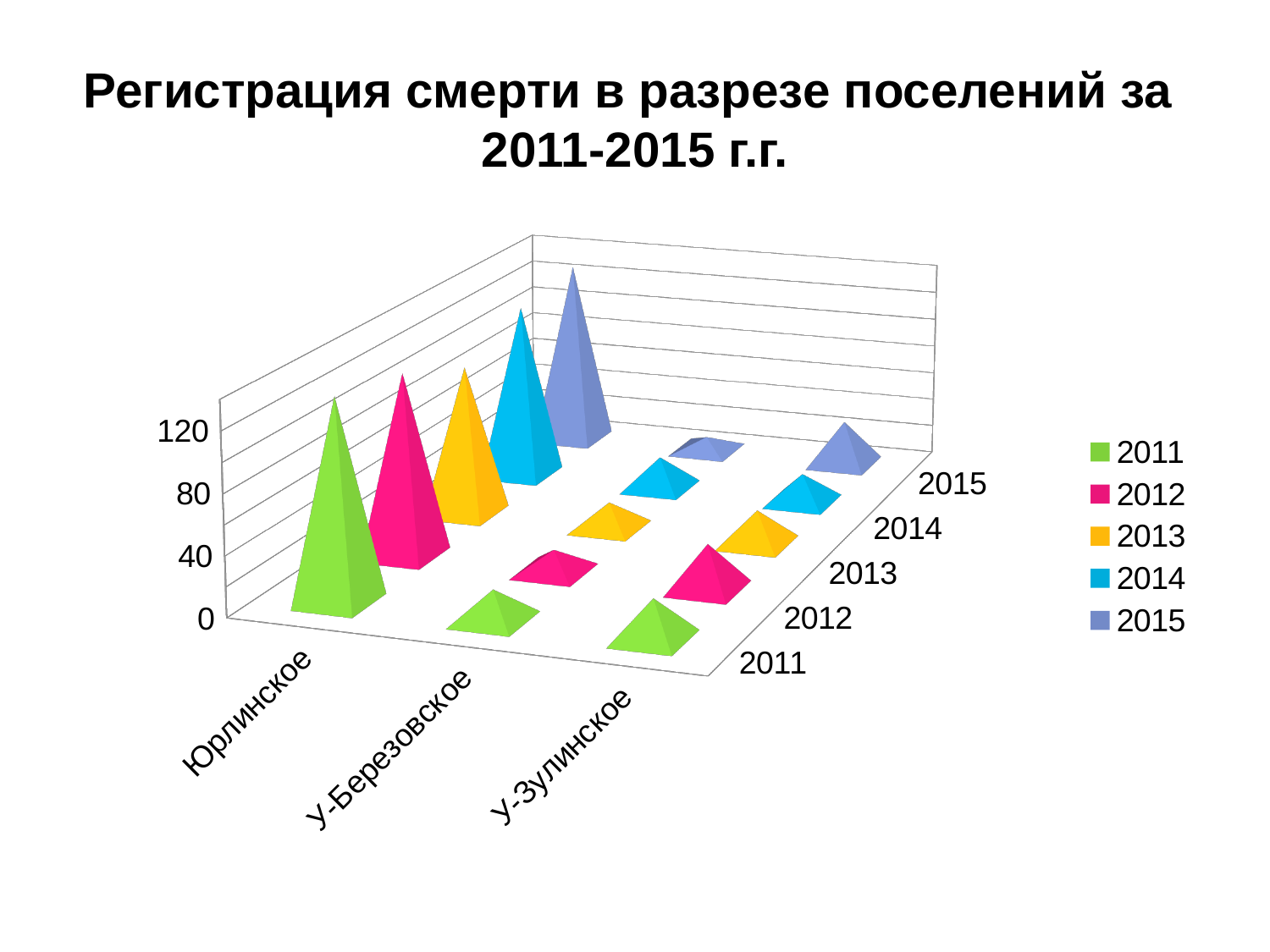
Is the value for у-Зулинское in 2015 greater or less than 40? less What is the title of the chart? Регистрация смерти в разрезе поселений за 2011-2015 г.г. Which is larger, the 2014 value for Юрлинское or the 2014 value for у-Березовское? Юрлинское Which settlement has the highest value in 2011? Юрлинское Which years are listed in the legend? 2011, 2012, 2013, 2014, 2015 Is the value for у-Березовское in 2011 greater or less than 40? less How many series does the legend list? 5 What kind of chart is shown on the slide? bar chart Which is larger, the 2013 value for Юрлинское or the 2013 value for у-Зулинское? Юрлинское How many settlements (categories) are shown on the chart? 3 Is the value for Юрлинское in 2011 greater or less than 40? greater Which settlement has the highest value in 2015? Юрлинское